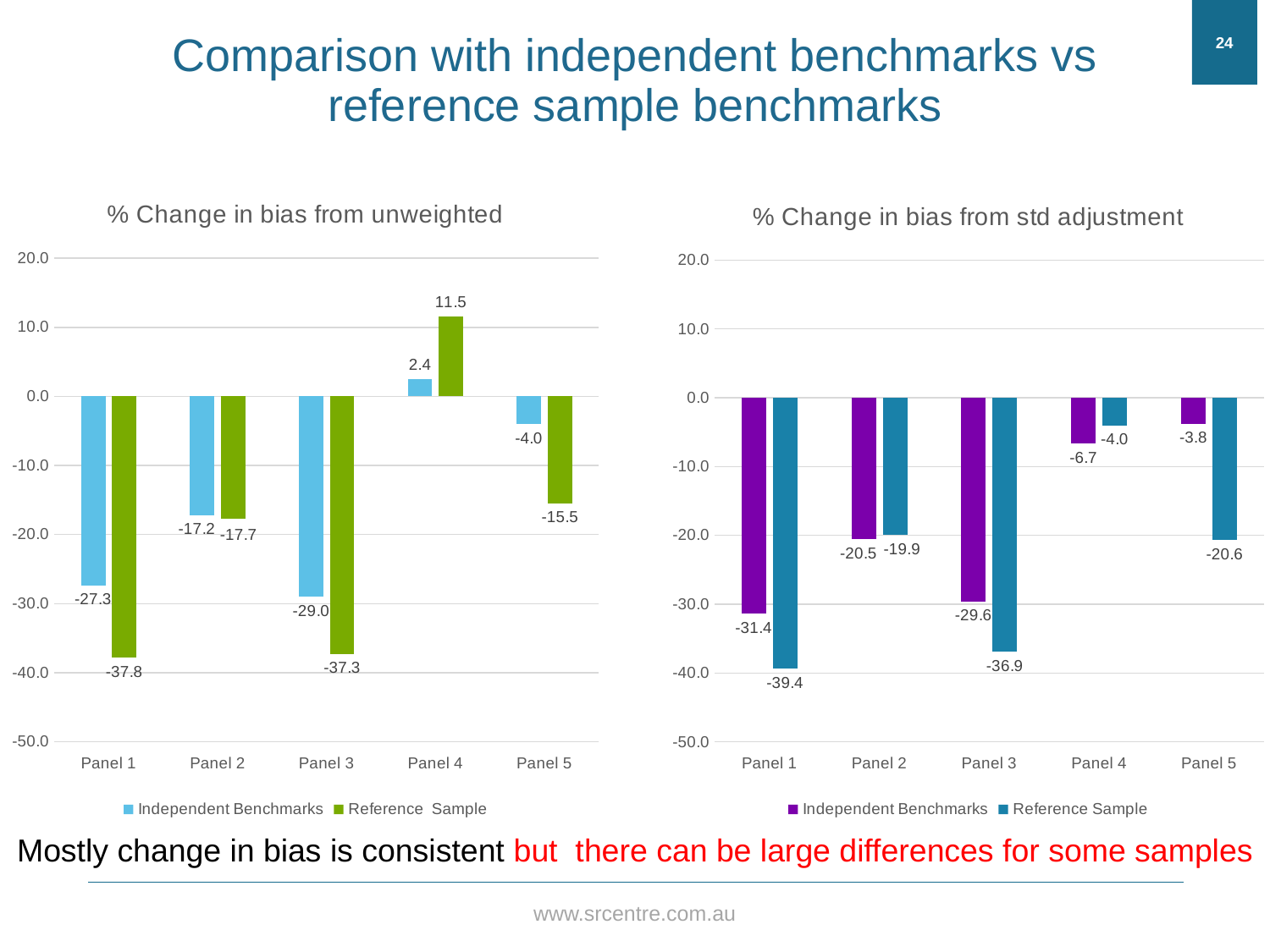
How many panels are shown on the x axis of the '% Change in bias from unweighted' chart? 5 In the '% Change in bias from unweighted' chart, what is the difference between the Reference Sample and Independent Benchmarks values in Panel 5? 11.5 In the '% Change in bias from unweighted' chart, what is the value for Reference Sample in Panel 1? -37.8 In the '% Change in bias from std adjustment' chart, which panel has the lowest Reference Sample value? Panel 1 In the '% Change in bias from std adjustment' chart, what is the value for Independent Benchmarks in Panel 3? -29.6 How many series does the legend of the '% Change in bias from std adjustment' chart list? 2 What type of chart is the '% Change in bias from unweighted' chart? Bar chart In the '% Change in bias from std adjustment' chart, what is the difference between the Independent Benchmarks and Reference Sample values in Panel 1? 8.0 In the '% Change in bias from unweighted' chart, which panel has the highest Reference Sample value? Panel 4 In the '% Change in bias from unweighted' chart, what is the value for Independent Benchmarks in Panel 4? 2.4 In the '% Change in bias from std adjustment' chart, what is the value for Reference Sample in Panel 5? -20.6 In the '% Change in bias from std adjustment' chart, which is larger in Panel 5: Independent Benchmarks or Reference Sample? Independent Benchmarks